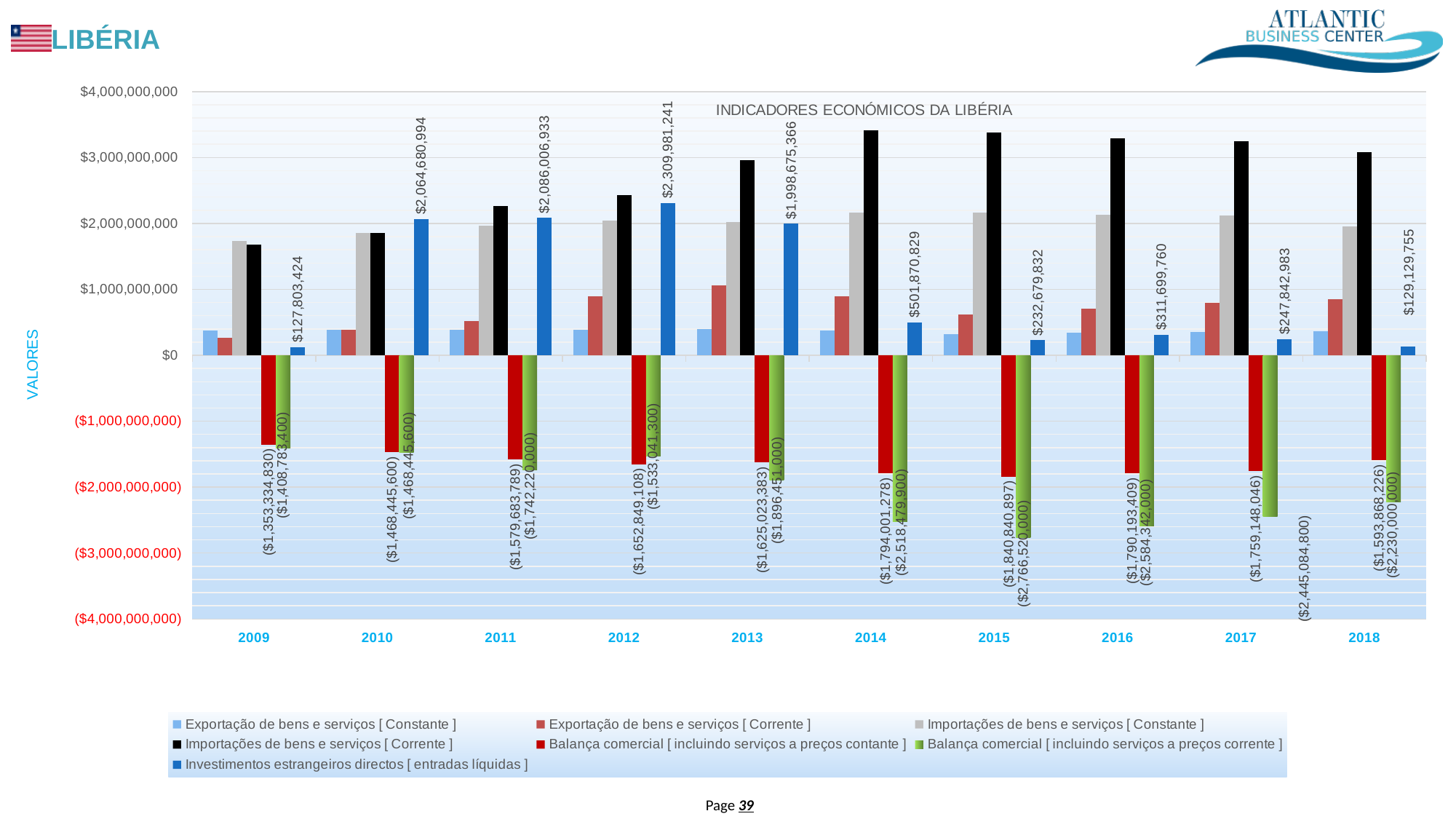
What is the value of Balança comercial [ incluindo serviços a preços corrente ] in 2015? ($2,766,520,000) Is the value for Importações de bens e serviços [ Corrente ] in 2014 greater or less than $3,000,000,000? greater What kind of chart is shown on the slide? bar chart What is the title of the chart? INDICADORES ECONÓMICOS DA LIBÉRIA What is the difference between Investimentos estrangeiros directos [ entradas líquidas ] in 2012 and in 2011? $223,974,308 What is the value of Investimentos estrangeiros directos [ entradas líquidas ] in 2012? $2,309,981,241 In which year is Investimentos estrangeiros directos [ entradas líquidas ] highest? 2012 What is the value of Balança comercial [ incluindo serviços a preços contante ] in 2009? ($1,353,334,830) In which year is Investimentos estrangeiros directos [ entradas líquidas ] lowest? 2009 Which year has the larger value for Investimentos estrangeiros directos [ entradas líquidas ], 2014 or 2015? 2014 How many years are shown on the x axis of the chart? 10 How many series does the chart's legend list? 7